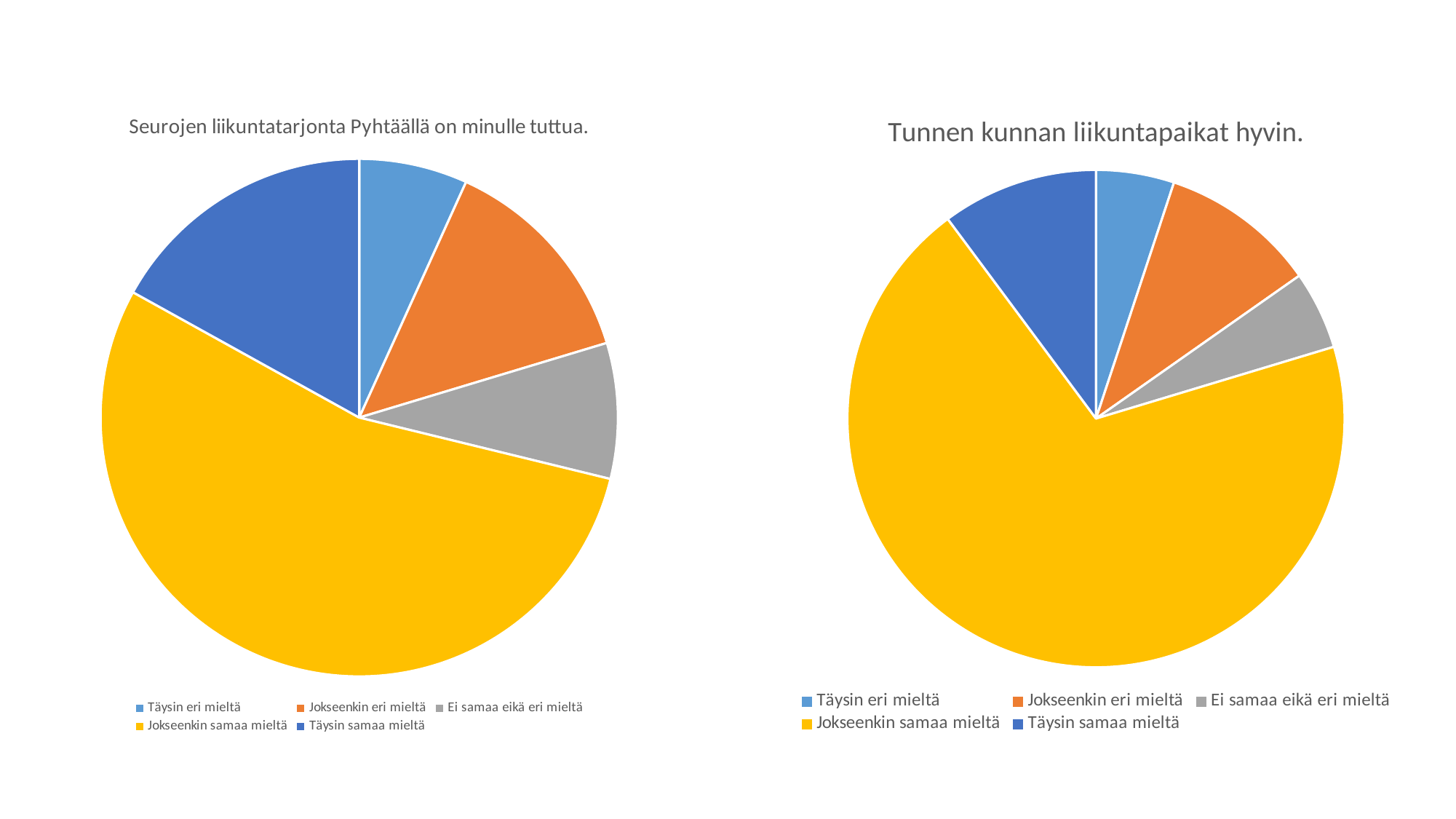
In the chart titled "Seurojen liikuntatarjonta Pyhtäällä on minulle tuttua.", which category has the largest slice? Jokseenkin samaa mieltä In the chart titled "Tunnen kunnan liikuntapaikat hyvin.", which slice is larger: Jokseenkin eri mieltä or Ei samaa eikä eri mieltä? Jokseenkin eri mieltä What is the title of the pie chart on the right side of the slide? Tunnen kunnan liikuntapaikat hyvin. In the chart titled "Tunnen kunnan liikuntapaikat hyvin.", which category has the largest slice? Jokseenkin samaa mieltä How many entries does the legend of the chart titled "Tunnen kunnan liikuntapaikat hyvin." list? 5 In the chart titled "Seurojen liikuntatarjonta Pyhtäällä on minulle tuttua.", what colour is the Ei samaa eikä eri mieltä slice? Gray In the chart titled "Seurojen liikuntatarjonta Pyhtäällä on minulle tuttua.", which slice is larger: Täysin samaa mieltä or Jokseenkin eri mieltä? Täysin samaa mieltä What kind of chart is the chart titled "Seurojen liikuntatarjonta Pyhtäällä on minulle tuttua."? Pie chart How many slices does the chart titled "Seurojen liikuntatarjonta Pyhtäällä on minulle tuttua." have? 5 What kind of chart is the chart titled "Tunnen kunnan liikuntapaikat hyvin."? Pie chart In the chart titled "Seurojen liikuntatarjonta Pyhtäällä on minulle tuttua.", which slice is larger: Jokseenkin samaa mieltä or Täysin samaa mieltä? Jokseenkin samaa mieltä How many slices does the chart titled "Tunnen kunnan liikuntapaikat hyvin." have? 5